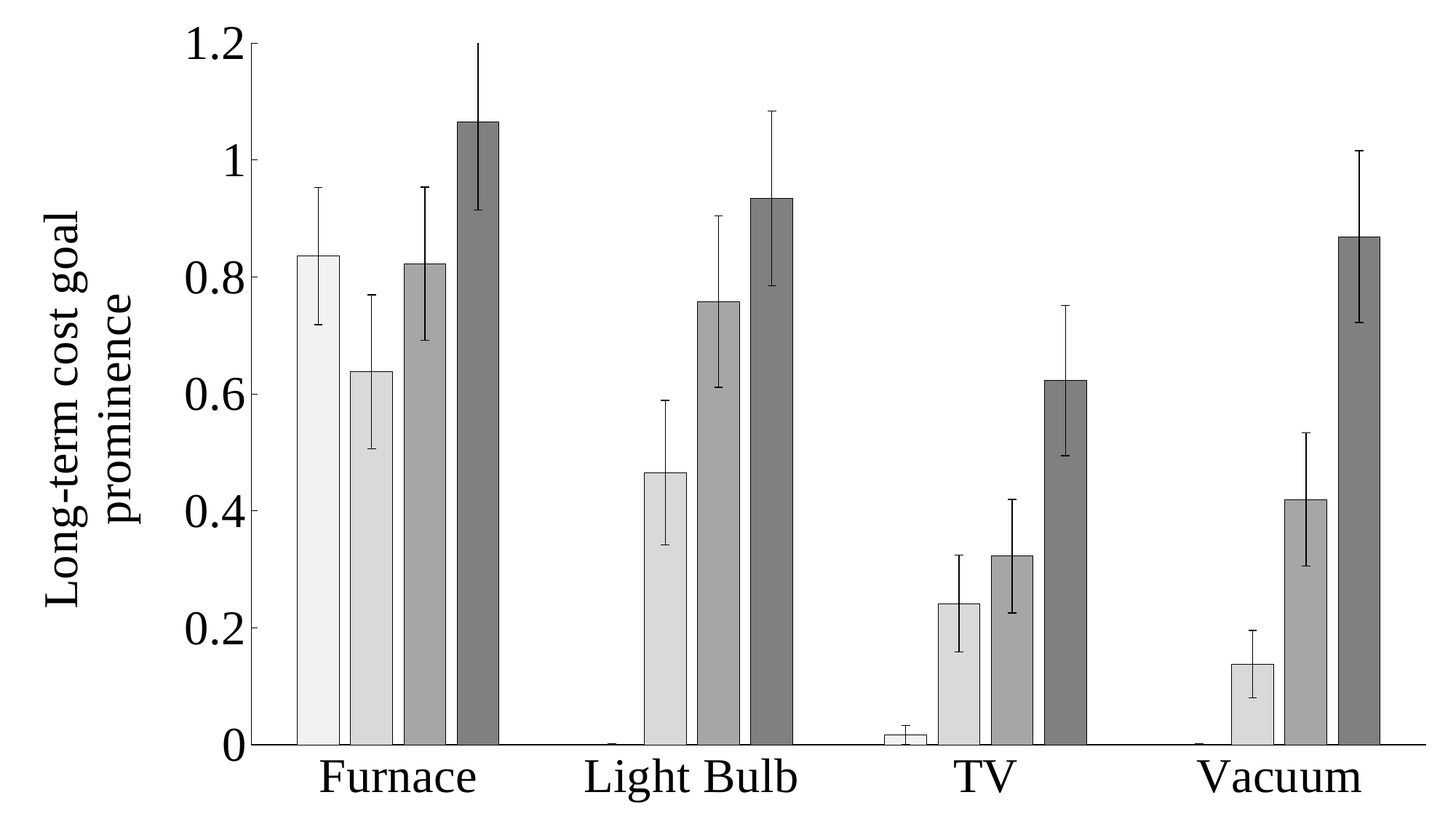
Is the value of the lightest (first) bar for Furnace greater or less than 0.6? greater For TV, which is taller: the third bar or the fourth bar? the fourth bar What is the label of the y axis? Long-term cost goal prominence Is the value of the darkest bar for Furnace greater or less than 1? greater Is the value of the darkest bar for TV greater or less than 0.8? less Which category has the tallest darkest (fourth) bar? Furnace Which category has the shortest darkest (fourth) bar? TV What is the highest tick value shown on the y axis? 1.2 How many bars are plotted for each category? 4 How many categories are shown on the x axis? 4 What kind of chart is shown on the slide? bar chart